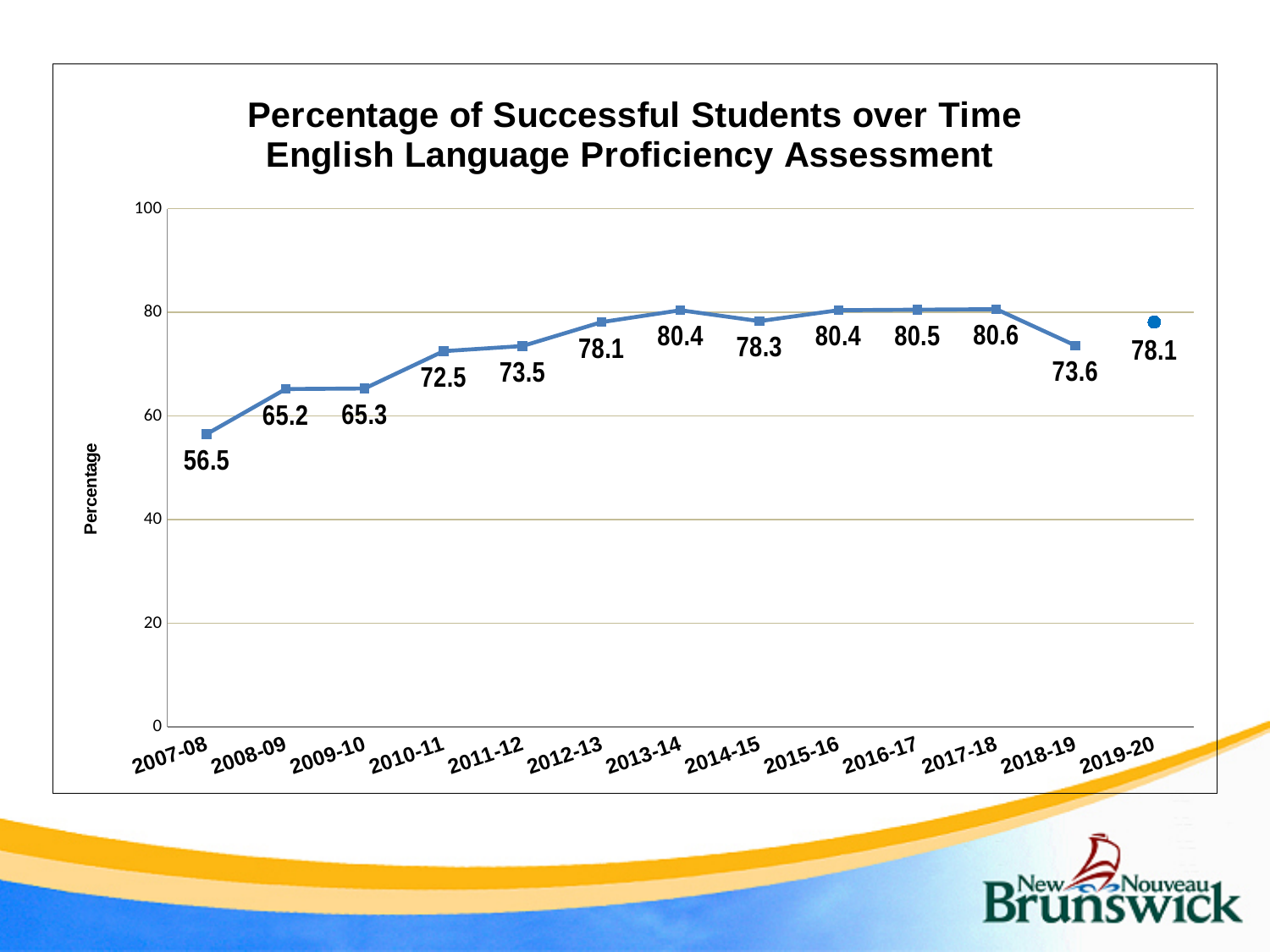
Which year has a higher percentage, 2010-11 or 2018-19? 2018-19 How many school years are plotted on the chart? 13 What is the percentage of successful students for 2007-08? 56.5 Do the values generally rise or fall from 2007-08 to 2013-14? rise Which year has the highest percentage of successful students? 2017-18 What kind of chart is shown on the slide? line chart What is the percentage of successful students for 2019-20? 78.1 What is the label on the vertical axis of the chart? Percentage What is the difference between the percentage for 2018-19 and 2007-08? 17.1 Which year has the lowest percentage of successful students? 2007-08 What is the percentage of successful students for 2013-14? 80.4 Is the value for 2012-13 greater or less than 80? less